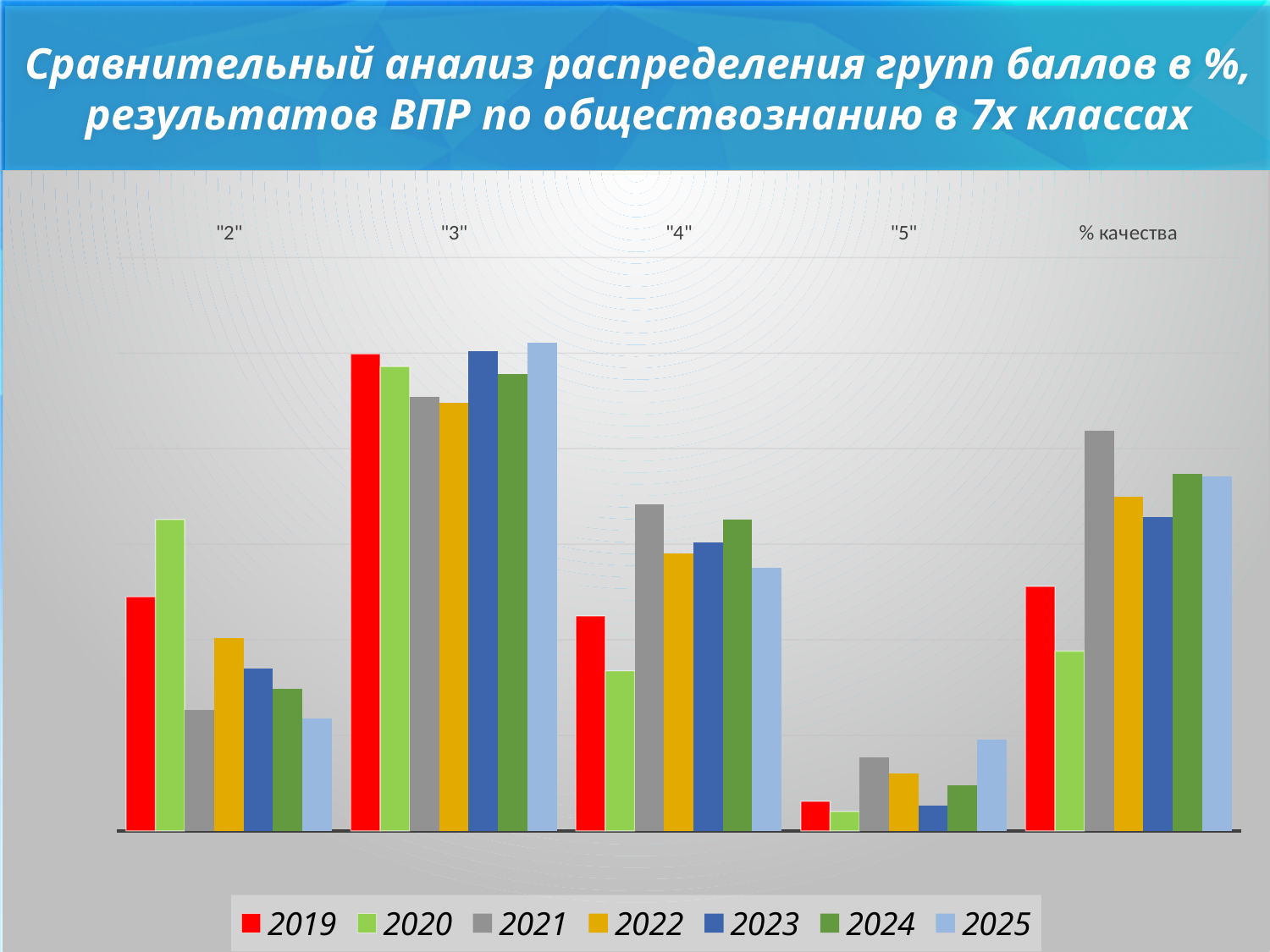
In the "2" category, which is larger: the bar for 2019 or the bar for 2021? 2019 Which colour represents the 2019 series in the legend? red In the "% качества" category, which year has the lowest bar? 2020 How many series does the legend list? 7 In the "4" category, which year has the lowest bar? 2020 In the "5" category, which year has the highest bar? 2025 In the "% качества" category, which year has the highest bar? 2021 In the "% качества" category, which is larger: the bar for 2019 or the bar for 2025? 2025 In the "2" category, which year has the highest bar? 2020 How many categories are shown along the x axis? 5 What kind of chart is shown on the slide? bar chart